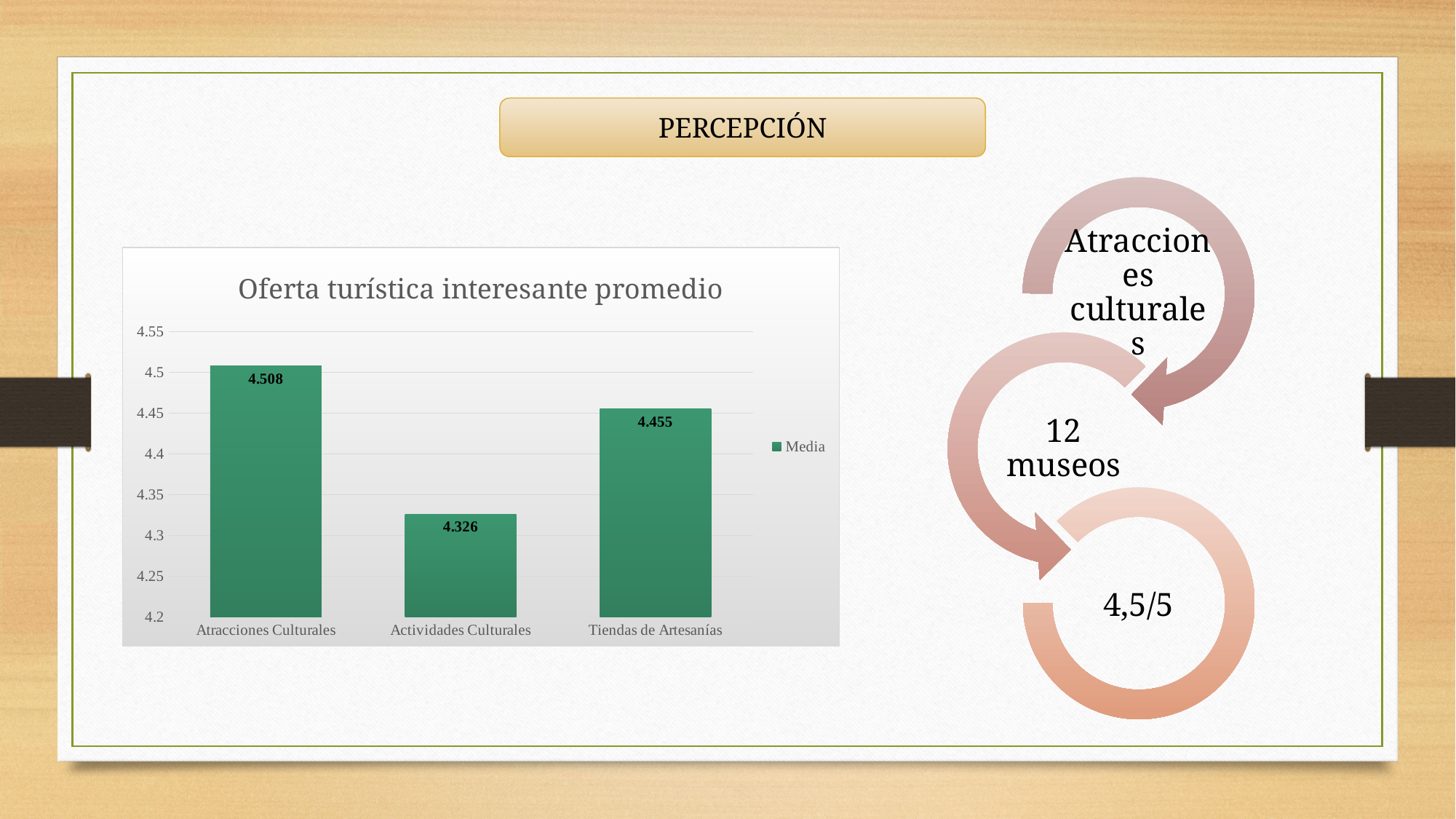
What is the value for Atracciones Culturales? 4.508 Which is larger, the value for Tiendas de Artesanías or the value for Actividades Culturales? Tiendas de Artesanías Which category has the lowest value? Actividades Culturales Is the value for Actividades Culturales greater or less than 4.35? less What is the difference between the values for Tiendas de Artesanías and Actividades Culturales? 0.129 What is the value for Actividades Culturales? 4.326 How many categories are shown in the chart? 3 Which category has the highest value? Atracciones Culturales What kind of chart is shown on the slide? bar chart What is the title of the chart? Oferta turística interesante promedio What is the difference between the values for Atracciones Culturales and Actividades Culturales? 0.182 What is the value for Tiendas de Artesanías? 4.455